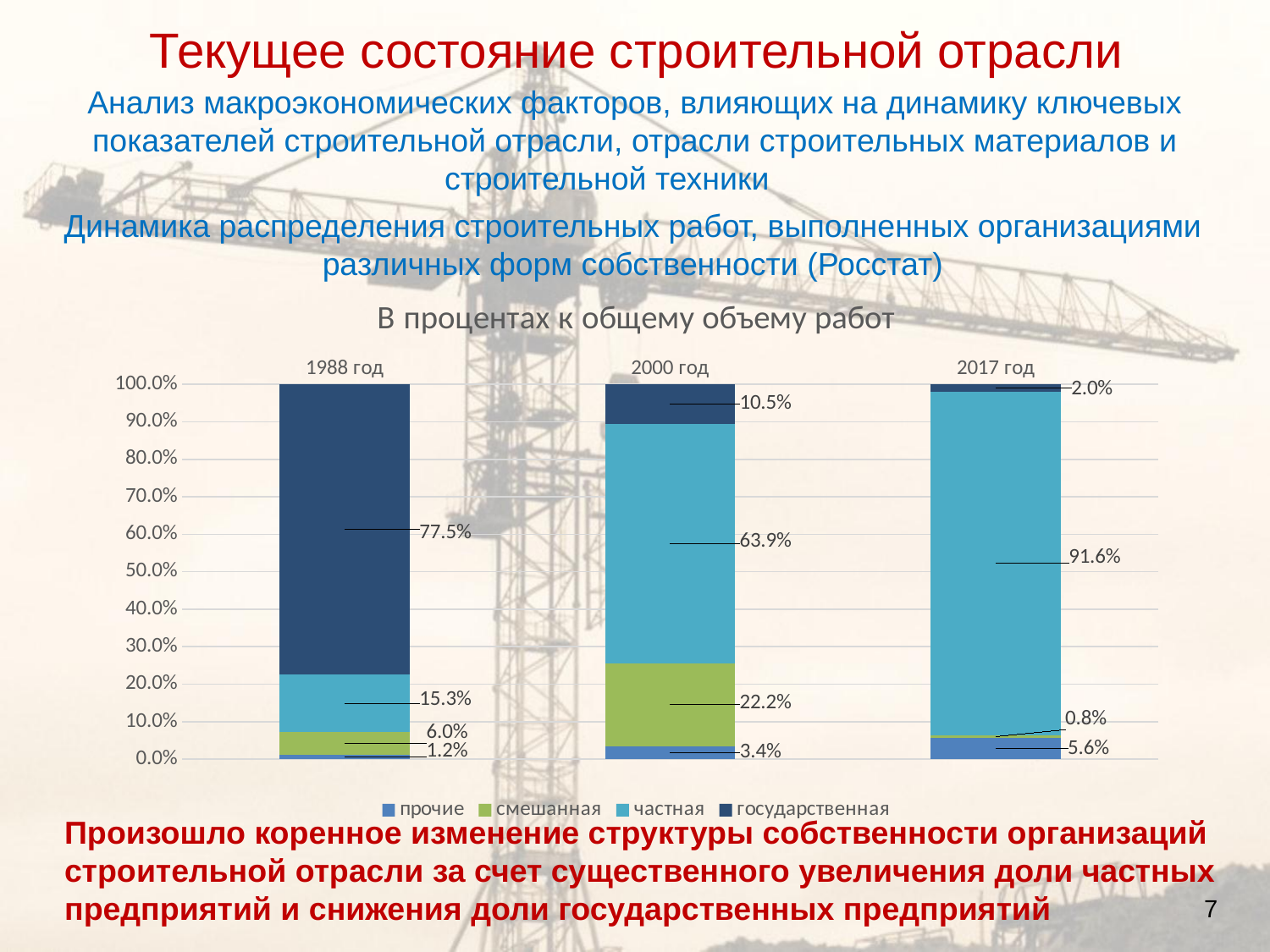
In which year is the share of частная the highest? 2017 год How many series does the legend list? 4 What kind of chart is shown on the slide? stacked bar chart Which is larger in 2000 год: the share of частная or the share of государственная? частная How many years (categories) are shown on the x axis? 3 What is the value for смешанная in 2000 год? 22.2% What is the value for государственная in 1988 год? 77.5% In which year is the share of государственная the lowest? 2017 год What is the value for частная in 2017 год? 91.6% What is the value for прочие in 2017 год? 5.6% What is the title of the chart? В процентах к общему объему работ What is the difference between the частная share in 2017 год and in 1988 год? 76.3%